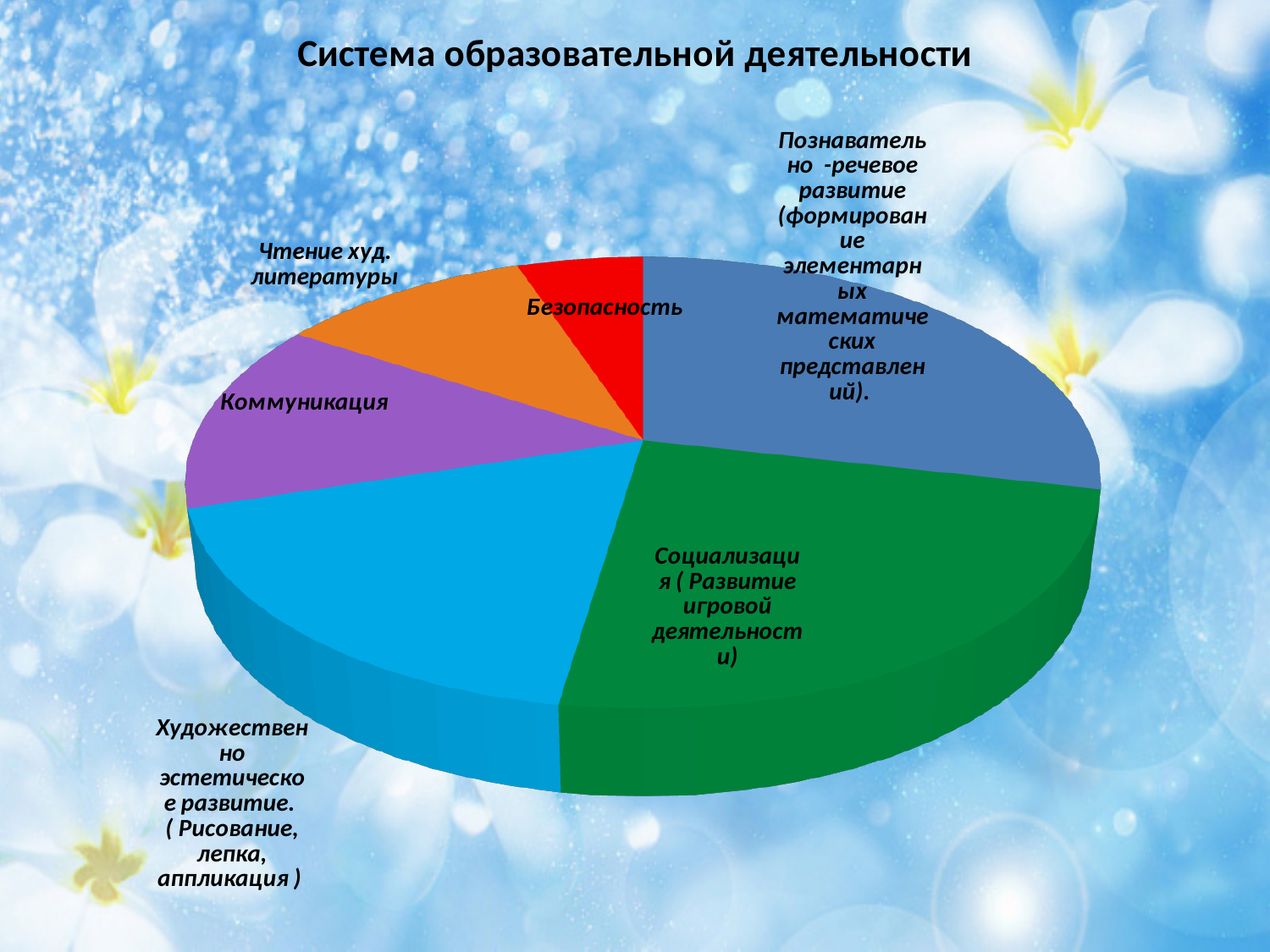
What colour is the Безопасность slice? Red How many slices does the pie chart have? 6 What is the title of the slide containing the pie chart? Система образовательной деятельности Which category has the smallest slice of the pie? Безопасность Which category has the largest slice of the pie? Социализация (Развитие игровой деятельности) Which slice is larger: Художественно эстетическое развитие or Чтение худ. литературы? Художественно эстетическое развитие Which slice is larger: Социализация (Развитие игровой деятельности) or Познавательно-речевое развитие? Социализация (Развитие игровой деятельности) Which slice is larger: Социализация (Развитие игровой деятельности) or Безопасность? Социализация (Развитие игровой деятельности) What kind of chart is shown on the slide? Pie chart